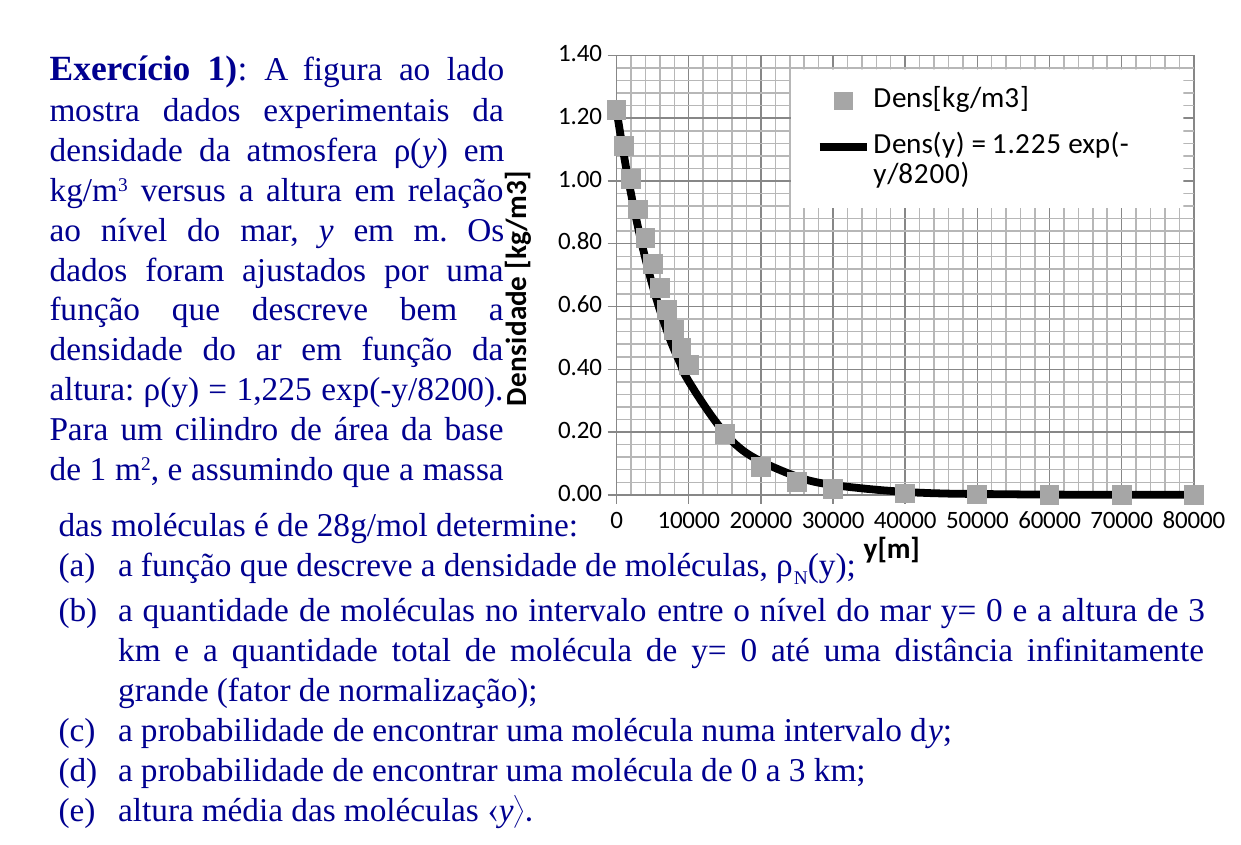
What is the label of the vertical axis? Densidade [kg/m3] Which has the larger density value, y = 10000 or y = 30000? y = 10000 At which value of y is the density highest? 0 How many series does the legend list? 2 What kind of chart is shown on the slide? Scatter chart with a fitted line What is the second legend entry of the chart? Dens(y) = 1.225 exp(-y/8200) Is the density value at y = 10000 greater or less than 0.20? greater Is the density value at y = 40000 greater or less than 0.20? less Is the density value at y = 0 greater or less than 1.00? greater Do the density values rise or fall as y increases along the x axis? Fall